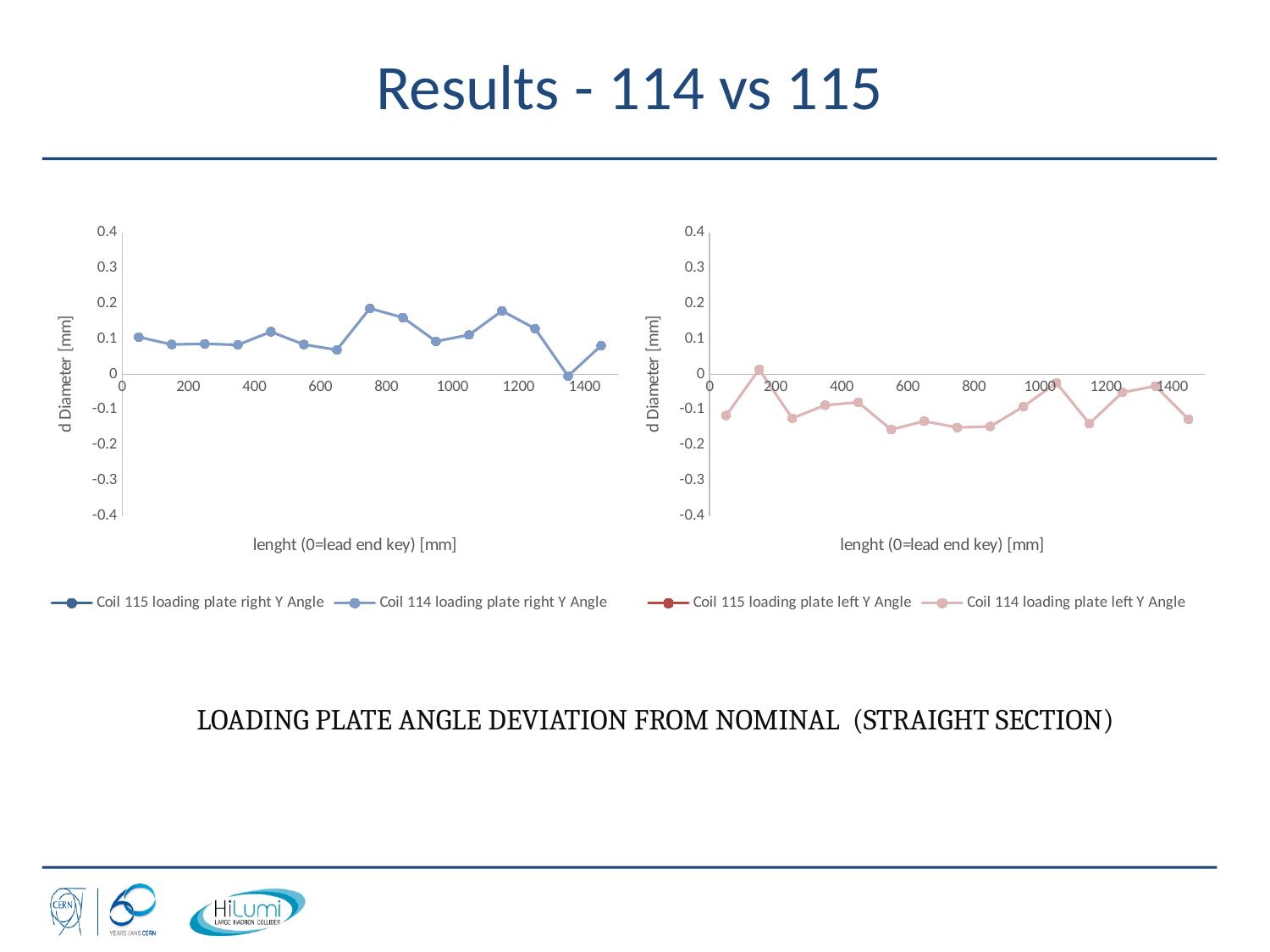
In the right chart, how many data points are plotted for Coil 114 loading plate left Y Angle? 15 In the left chart, is the value for Coil 114 loading plate right Y Angle at length 750 mm greater or less than 0.1? greater How many series does the legend of the left chart list? 2 In the right chart, which is larger for Coil 114 loading plate left Y Angle: the value at 150 mm or the value at 250 mm? 150 mm What kind of chart is the left chart on the slide? line chart In the left chart, at which length does Coil 114 loading plate right Y Angle reach its lowest value? 1350 mm In the right chart, is the value for Coil 114 loading plate left Y Angle at length 550 mm greater or less than -0.1? less In the left chart, is the value for Coil 114 loading plate right Y Angle at length 650 mm greater or less than 0.1? less How many series does the legend of the right chart list? 2 In the left chart, how many data points are plotted for Coil 114 loading plate right Y Angle? 15 What is the y-axis label of the right chart? d Diameter [mm] In the right chart, at which length does Coil 114 loading plate left Y Angle reach its highest value? 150 mm